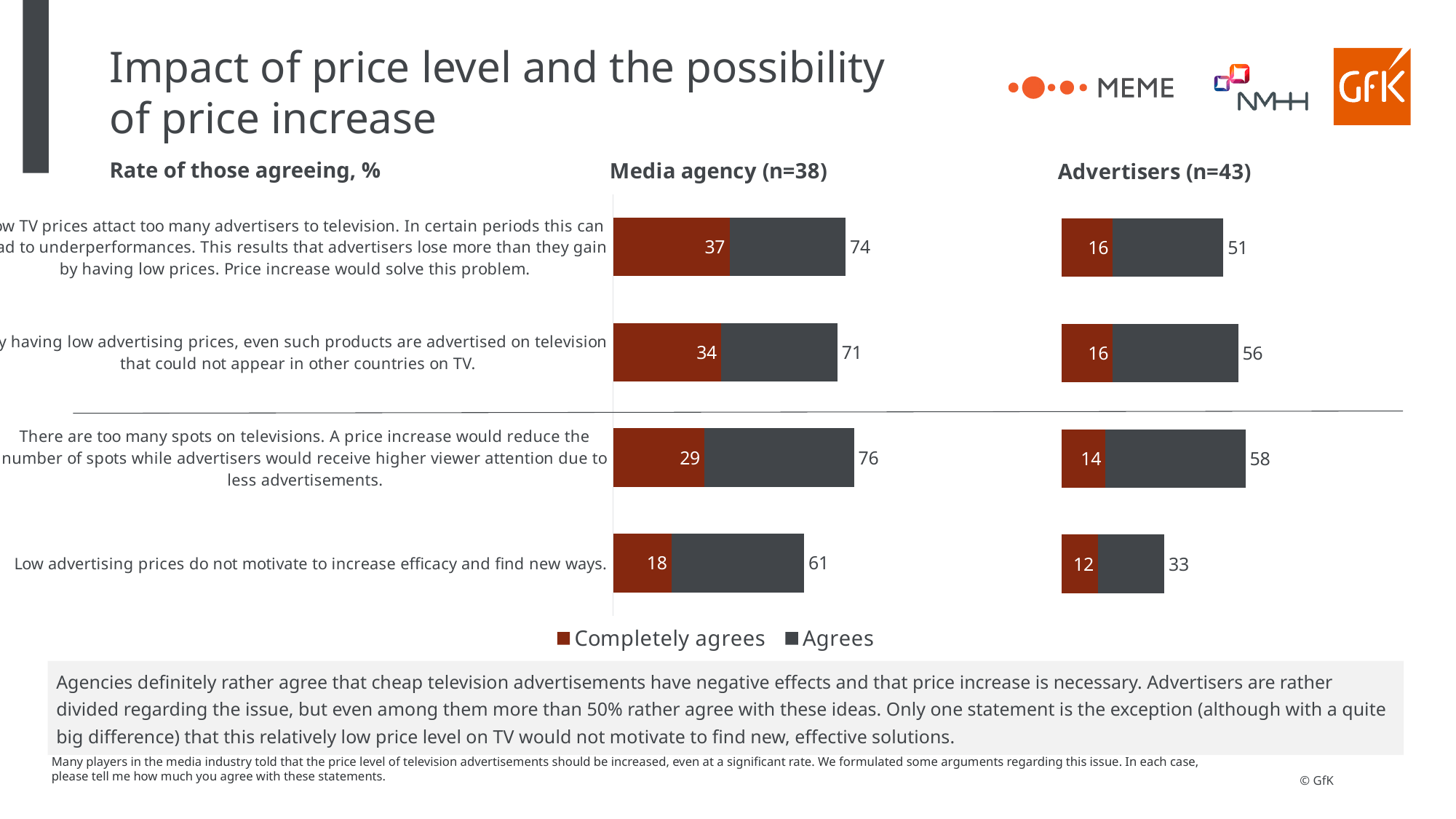
In the Advertisers (n=43) chart, which statement has the lowest total rate of agreement? Low advertising prices do not motivate to increase efficacy and find new ways. How many statements are plotted in the Advertisers (n=43) chart? 4 In the Advertisers (n=43) chart, what is the 'Completely agrees' value for the statement about there being too many spots on televisions? 14 What type of chart is used for the Media agency (n=38) data? Stacked bar chart In the Media agency (n=38) chart, what is the 'Completely agrees' value for the first (topmost) statement? 37 In the Media agency (n=38) chart, what is the 'Completely agrees' value for the statement 'Low advertising prices do not motivate to increase efficacy and find new ways.'? 18 For the statement 'Low advertising prices do not motivate to increase efficacy and find new ways.', what is the difference between the total agreement rate in the Media agency chart and in the Advertisers chart? 28 In the Advertisers (n=43) chart, what is the total rate of those agreeing with the statement 'Low advertising prices do not motivate to increase efficacy and find new ways.'? 33 For the statement about too many spots on televisions, which group has the higher total agreement rate: Media agency or Advertisers? Media agency In the Media agency (n=38) chart, what is the total rate of those agreeing with the statement about there being too many spots on televisions? 76 How many series does the legend list for the charts? 2 In the Media agency (n=38) chart, which statement has the highest total rate of agreement? There are too many spots on televisions. A price increase would reduce the number of spots while advertisers would receive higher viewer attention due to less advertisements.